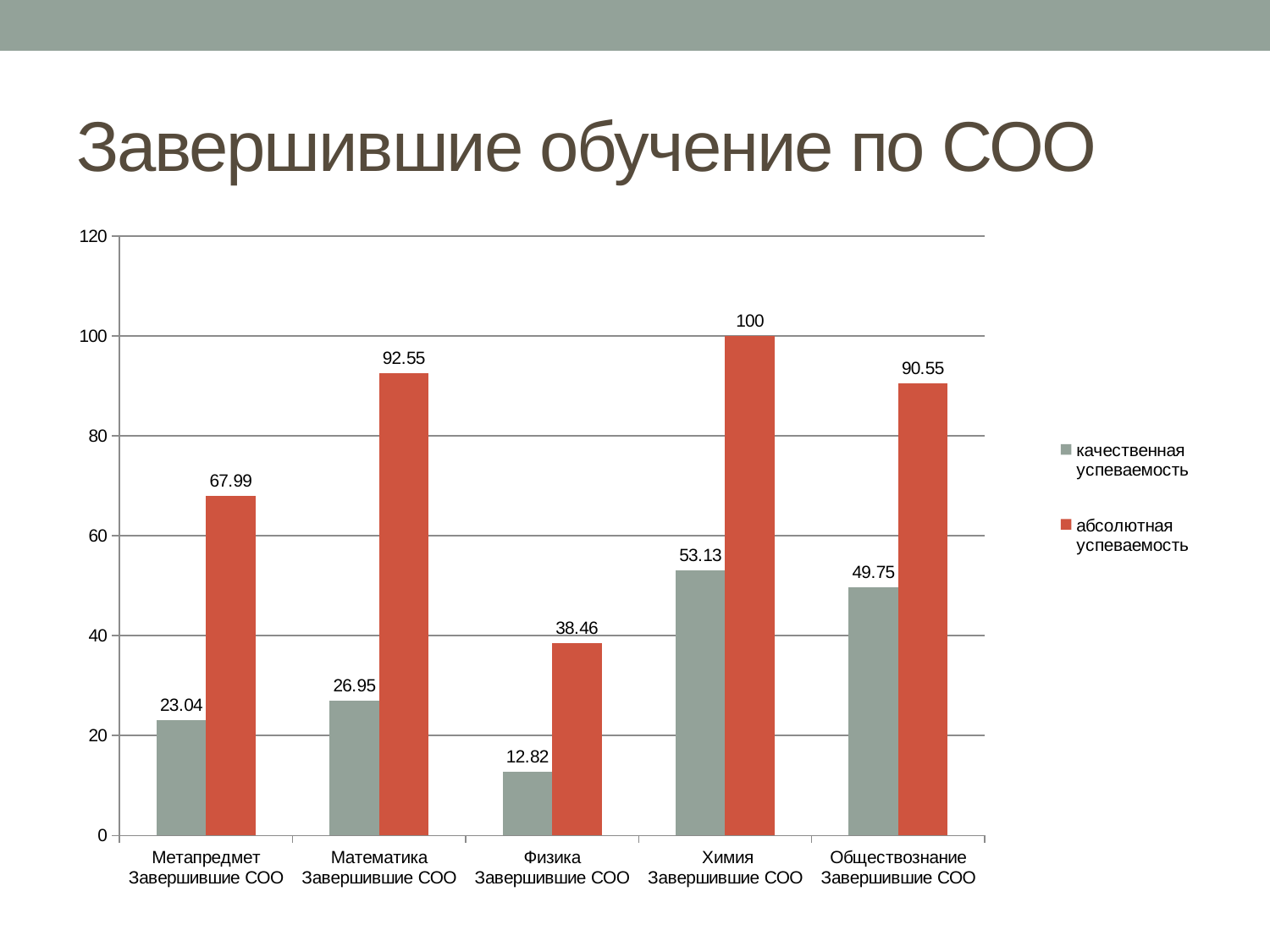
Is the value of абсолютная успеваемость for Математика greater or less than 80? greater What is the difference between абсолютная успеваемость and качественная успеваемость for Метапредмет? 44.95 What is the value of качественная успеваемость for Математика? 26.95 Which is larger: качественная успеваемость for Химия or for Обществознание? Химия How many series does the legend list? 2 Which category has the highest абсолютная успеваемость? Химия What is the title of the slide? Завершившие обучение по СОО How many categories are shown on the x axis? 5 What is the value of абсолютная успеваемость for Обществознание? 90.55 What is the value of абсолютная успеваемость for Физика? 38.46 Which category has the lowest качественная успеваемость? Физика What kind of chart is shown on the slide? bar chart